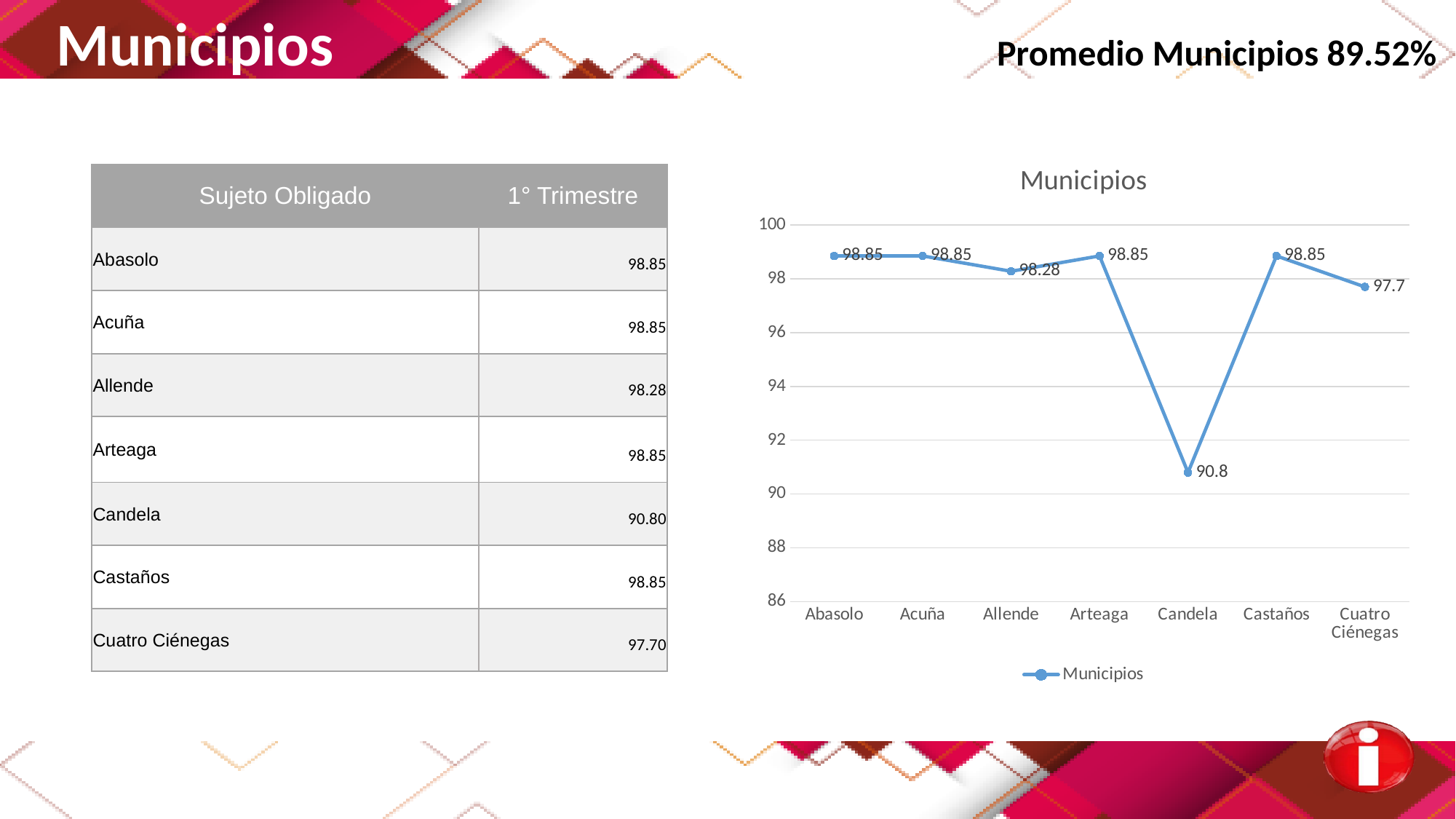
What is the difference between the values for Arteaga and Allende in the Municipios chart? 0.57 How many series does the legend of the Municipios chart list? 1 Is the value for Candela in the Municipios chart greater or less than 92? less Which is larger in the Municipios chart, the value for Allende or the value for Cuatro Ciénegas? Allende What is the value for Candela in the Municipios chart? 90.8 How many categories are plotted on the x axis of the Municipios chart? 7 What is the difference between the values for Castaños and Candela in the Municipios chart? 8.05 What is the value for Cuatro Ciénegas in the Municipios chart? 97.7 What type of chart is shown on the slide? line chart Which category has the lowest value in the Municipios chart? Candela What is the title of the chart on the slide? Municipios What is the value for Allende in the Municipios chart? 98.28